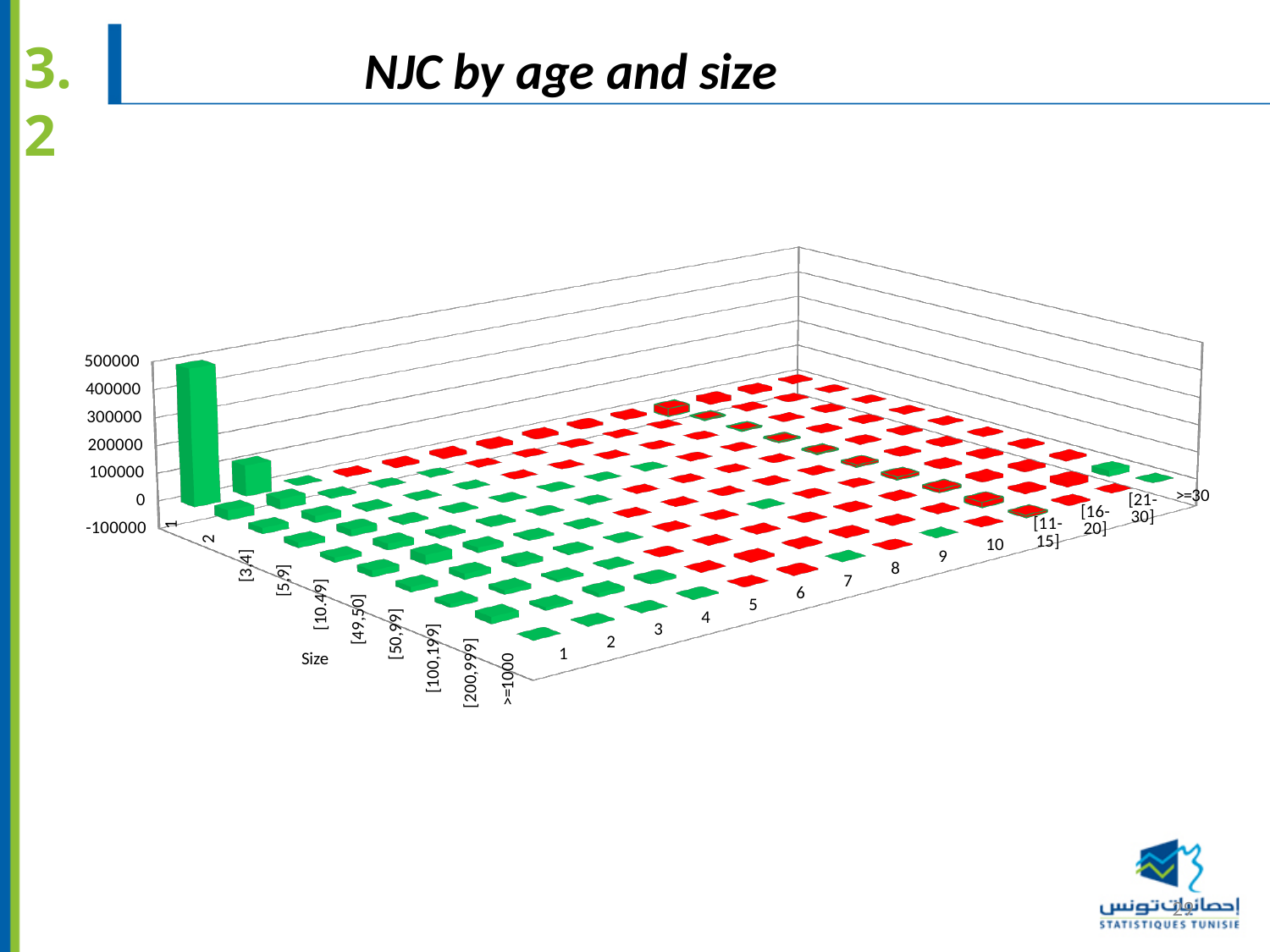
How many age categories are shown along the age axis? 14 What is the last size category shown on the Size axis? >=1000 What kind of chart is shown on the slide? bar chart What is the highest value shown on the vertical axis? 500000 Is the value for size 1 at age 1 greater or less than 300000? greater What is the last age category shown on the age axis? >=30 What is the title of the chart? NJC by age and size What is the label of the axis listing the categories 1, 2, [3,4], [5,9] and so on? Size What is the lowest value shown on the vertical axis? -100000 Which size category has the tallest bar in the chart? 1 How many size categories are shown along the Size axis? 10